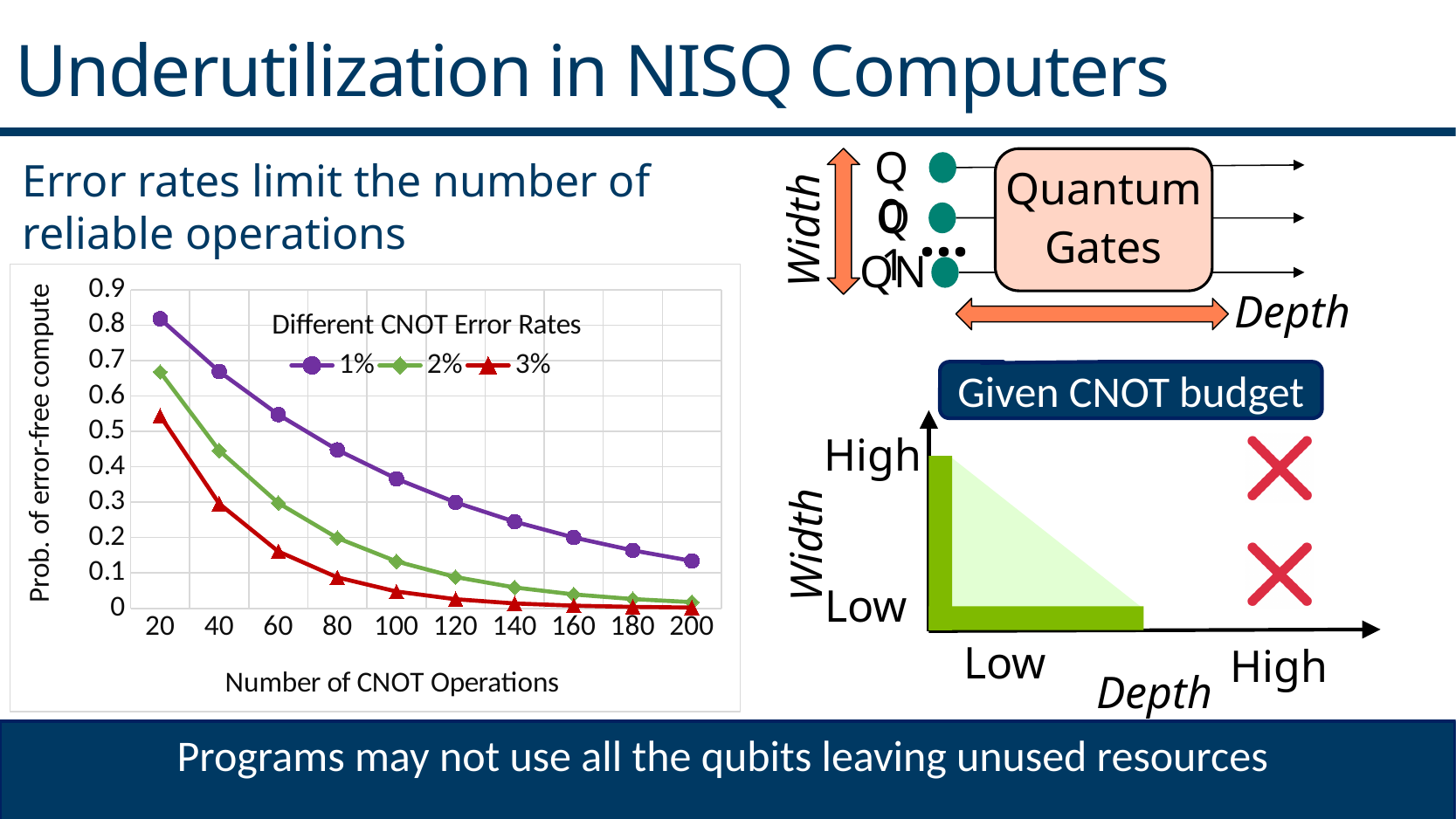
In the left chart, which CNOT error rate series has the lowest probability at 200 CNOT operations? 3% What kind of chart is shown on the left of the slide? line chart How many data points are plotted for the 1% series in the left chart? 10 In the left chart, at 60 CNOT operations, which series has the larger value: 1% or 3%? 1% In the left chart, does the probability of error-free compute rise or fall as the number of CNOT operations increases? fall How many series does the legend of the left chart list? 3 In the left chart, which CNOT error rate series has the highest probability at 20 CNOT operations? 1% In the left chart, is the value for the 3% series at 100 CNOT operations greater or less than 0.1? less In the left chart, is the value for the 2% series at 20 CNOT operations greater or less than 0.7? less What is the x-axis label of the left chart? Number of CNOT Operations In the left chart, is the value for the 1% series at 100 CNOT operations greater or less than 0.3? greater What is the legend title of the left chart? Different CNOT Error Rates